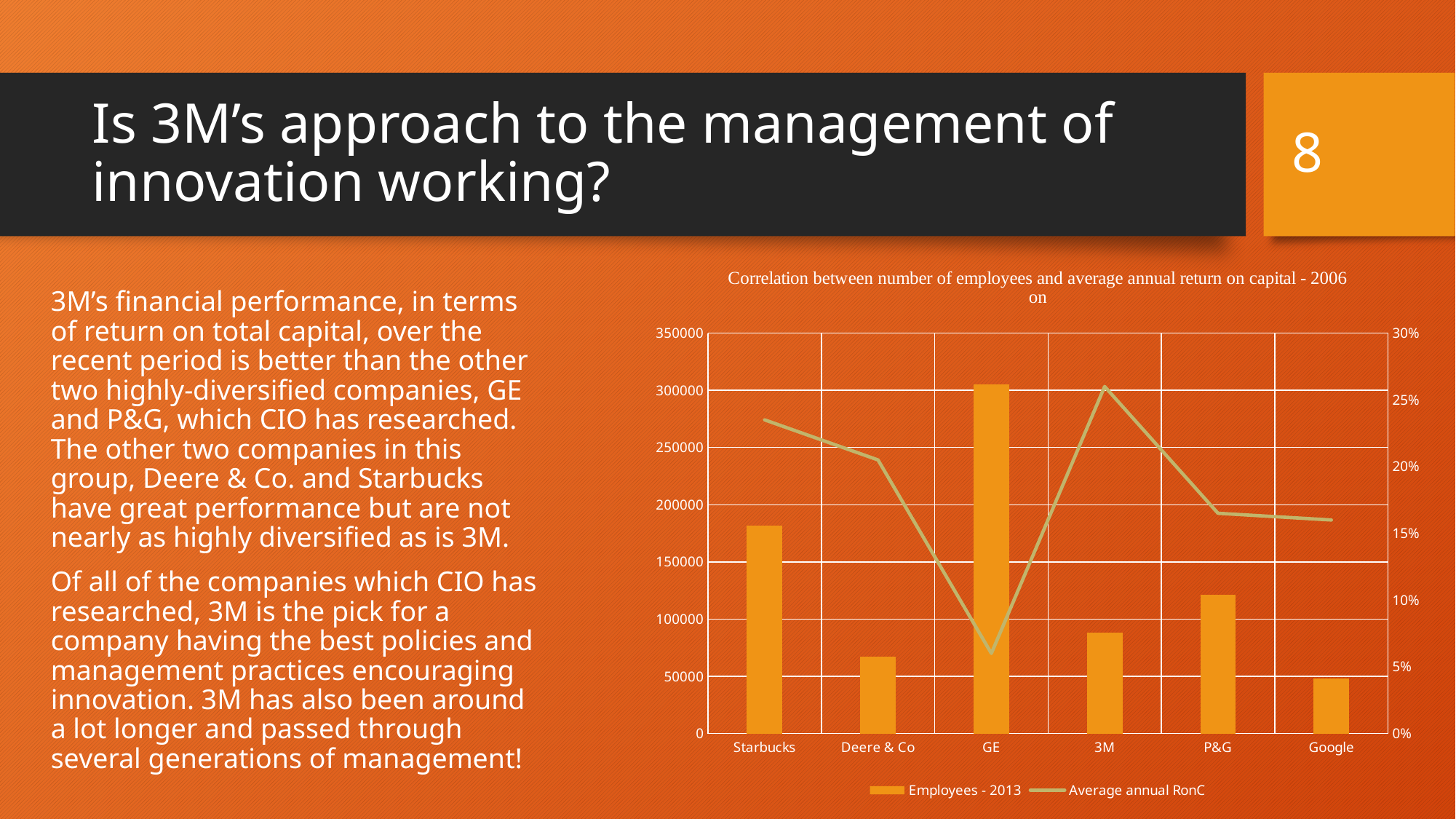
Is the Employees - 2013 value for Starbucks greater or less than 150000? greater Which company has the highest average annual RonC on the chart? 3M Which has more employees in 2013, Starbucks or P&G? Starbucks Is the Average annual RonC value for Starbucks greater or less than 20%? greater Which company has the lowest number of employees in 2013 on the chart? Google How many companies are shown on the x axis of the chart? 6 How many series does the chart legend list? 2 Is the Average annual RonC value for GE greater or less than 10%? less Which company has the highest number of employees in 2013 on the chart? GE What kind of chart is shown on the slide? Combination bar and line chart Which company has the lowest average annual RonC on the chart? GE